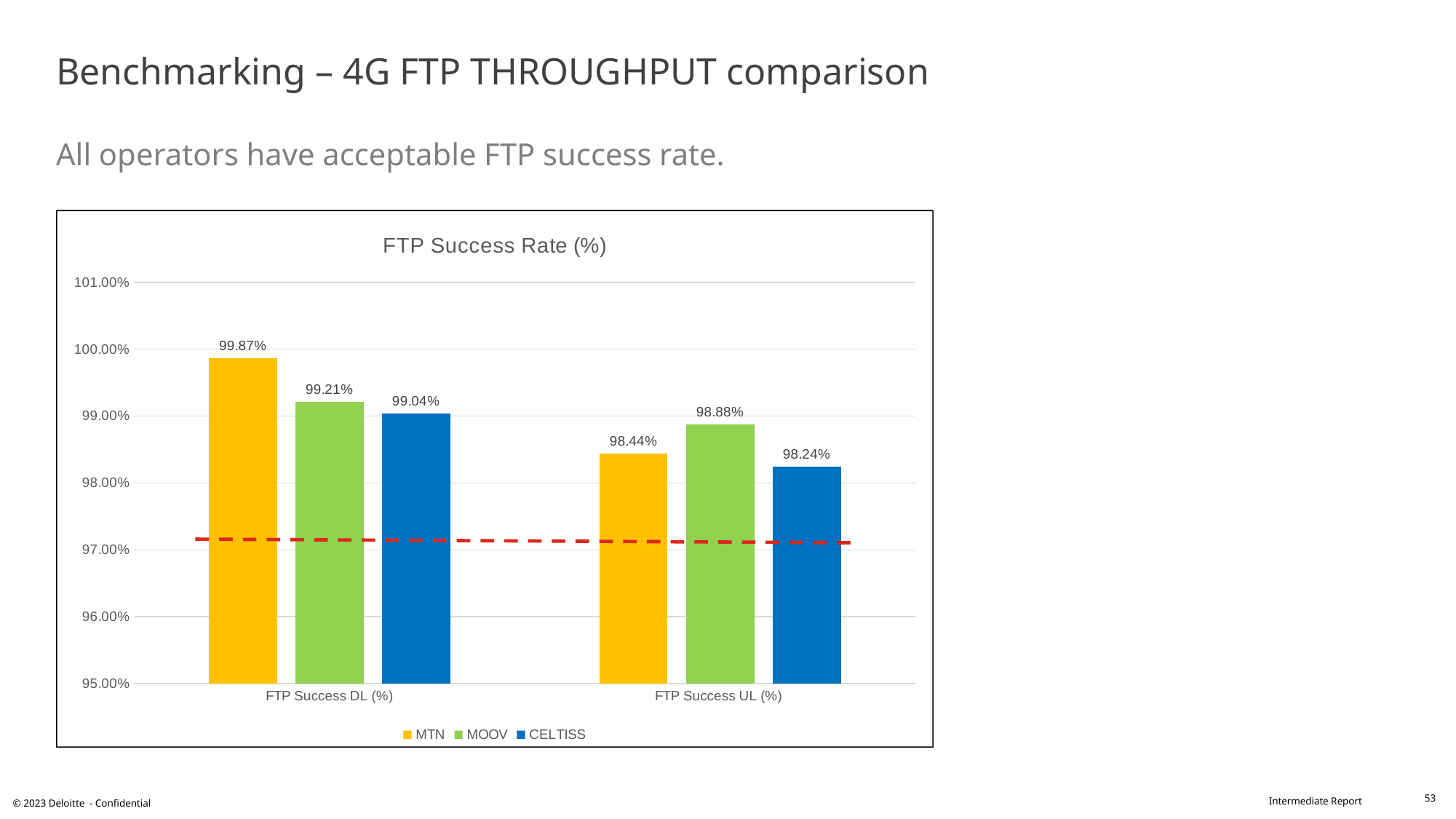
Which operator has the highest FTP Success UL (%)? MOOV What is the FTP Success UL (%) value for MOOV? 98.88% Which operator has the lowest FTP Success UL (%)? CELTISS What is the FTP Success UL (%) value for CELTISS? 98.24% Is the FTP Success UL (%) value for MTN greater or less than 99.00%? less What kind of chart is shown on the slide? Bar chart How many series does the legend list? 3 Which is larger: MOOV's FTP Success DL (%) or CELTISS's FTP Success DL (%)? MOOV's FTP Success DL (%) What is the title of the chart? FTP Success Rate (%) What is the difference between MTN's FTP Success DL (%) and its FTP Success UL (%)? 1.43% What is the FTP Success DL (%) value for MTN? 99.87% Which operator has the highest FTP Success DL (%)? MTN